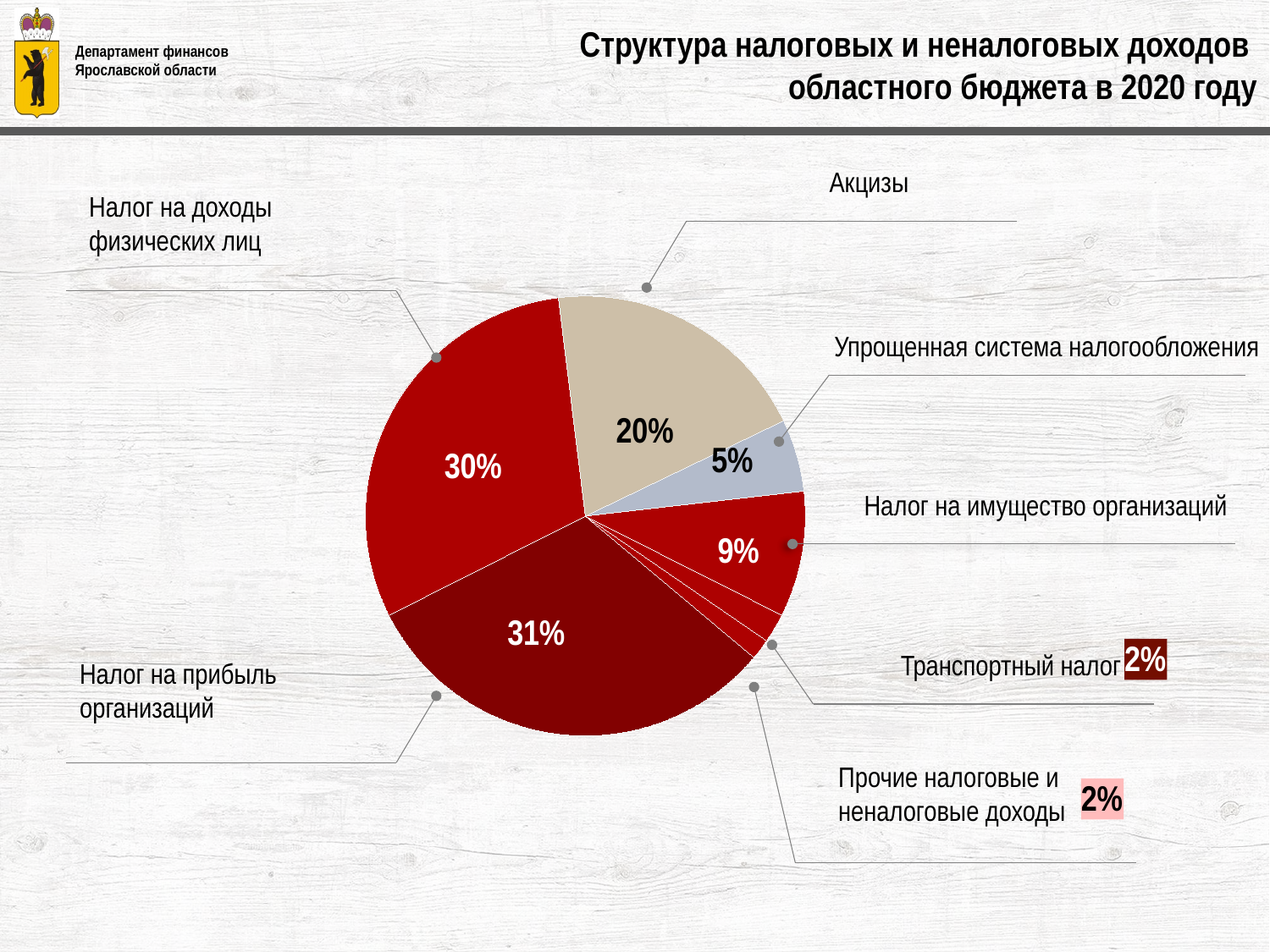
What type of chart is shown on the slide? Pie chart What share of the pie does "Транспортный налог" have? 2% Which category has the largest share of the pie? Налог на прибыль организаций Which is larger: the share of "Налог на прибыль организаций" or the share of "Налог на доходы физических лиц"? Налог на прибыль организаций What share of the pie does "Налог на прибыль организаций" have? 31% What share of the pie does "Прочие налоговые и неналоговые доходы" have? 2% What share of the pie does "Упрощенная система налогообложения" have? 5% What share of the pie does "Акцизы" have? 20% What is the title of the chart on the slide? Структура налоговых и неналоговых доходов областного бюджета в 2020 году What share of the pie does "Налог на имущество организаций" have? 9% What share of the pie does "Налог на доходы физических лиц" have? 30% What is the difference in percentage points between the share of "Акцизы" and the share of "Налог на имущество организаций"? 11